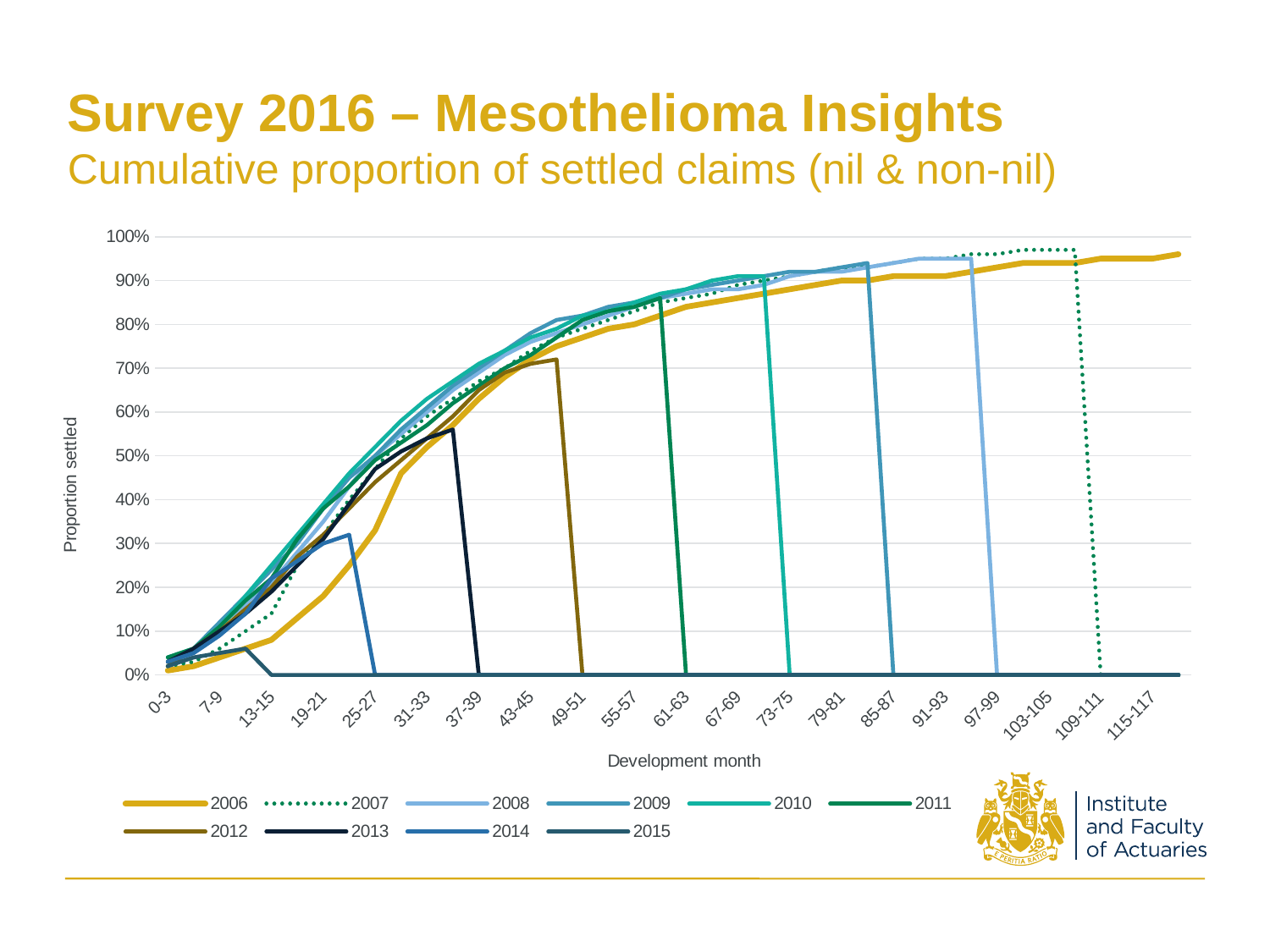
What is the label of the vertical axis? Proportion settled Does the 2006 series rise or fall as development month increases? rise How many series does the legend list? 10 Is the peak value reached by the 2013 series greater or less than 50%? greater Is the value for 2006 at development month 115-117 greater or less than 90%? greater Which series is drawn with a dotted line? 2007 Is the peak value reached by the 2014 series greater or less than 40%? less At development month 13-15, which series has the larger value, 2006 or 2010? 2010 What kind of chart is shown on the slide? line chart At development month 25-27, which series has the larger value, 2006 or 2013? 2013